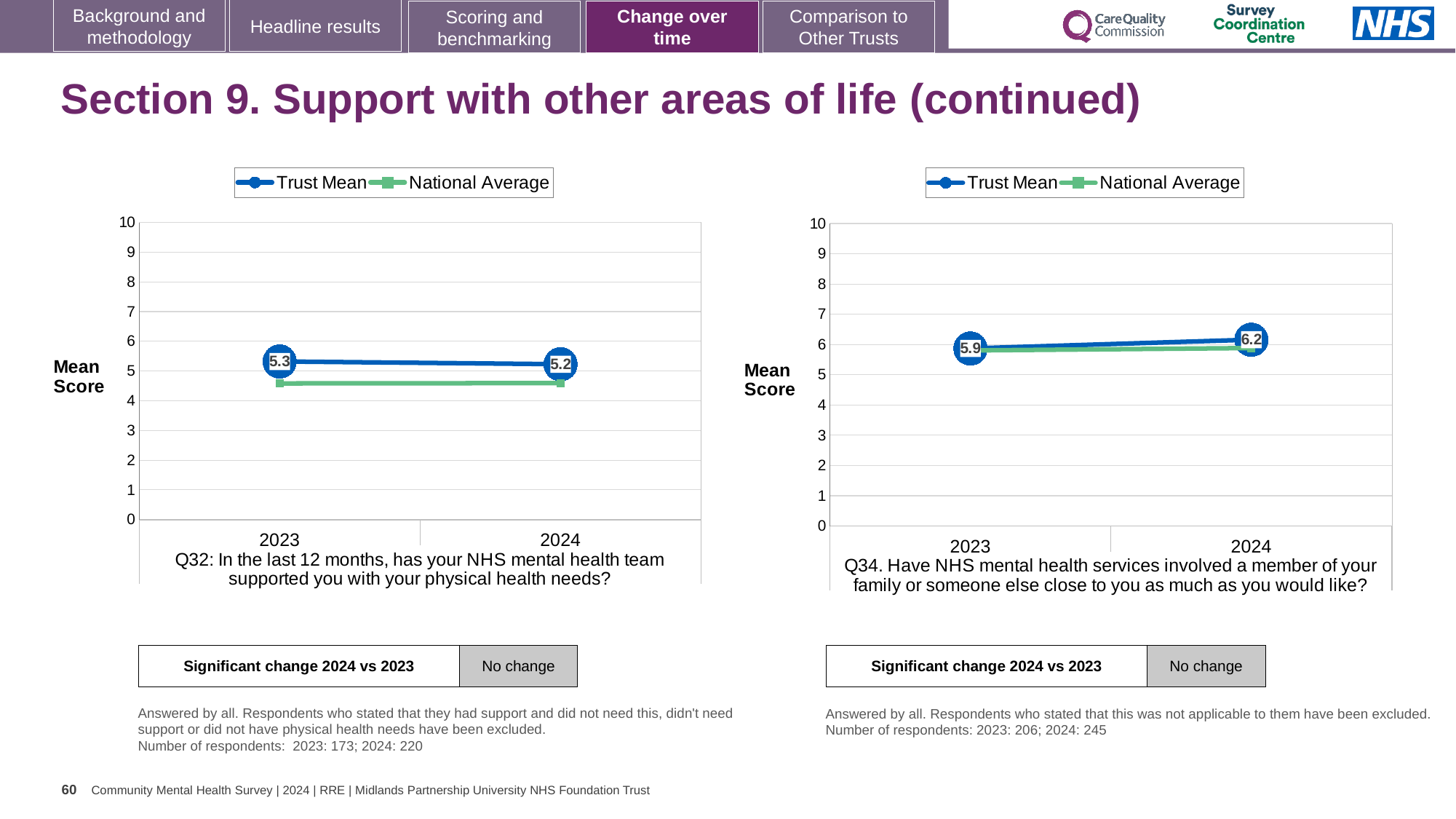
In the right chart (Q34), by how much did the Trust Mean change from 2023 to 2024? 0.3 In the left chart (Q32), is the Trust Mean in 2023 higher or lower than the National Average in 2023? higher In the right chart (Q34), what is the Trust Mean for 2023? 5.9 In the left chart (Q32), what is the difference between the Trust Mean in 2023 and 2024? 0.1 In the left chart (Q32), what is the Trust Mean for 2023? 5.3 In the right chart (Q34), what is the Trust Mean for 2024? 6.2 In the right chart (Q34), does the Trust Mean rise or fall from 2023 to 2024? rise In the left chart (Q32), is the National Average for 2024 greater or less than 5? less In the right chart (Q34), is the National Average for 2023 greater or less than 5? greater In the left chart (Q32), what is the Trust Mean for 2024? 5.2 How many series does the legend of the right chart (Q34) list? 2 What type of chart is the left chart (Q32)? line chart